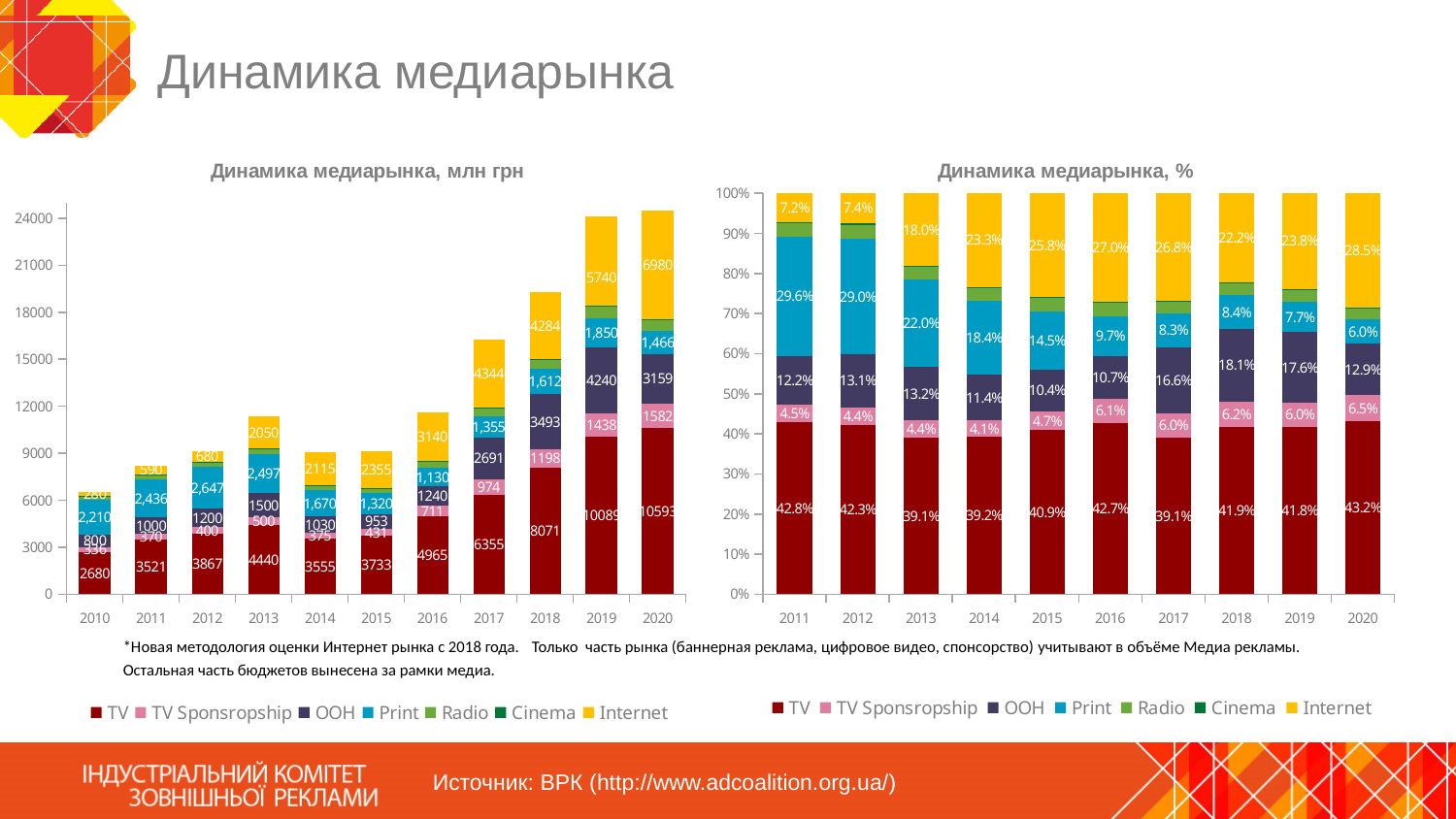
How many years are shown on the x axis of the chart 'Динамика медиарынка, %'? 10 In the chart 'Динамика медиарынка, %', what is the Print share in 2011? 29.6% In the chart 'Динамика медиарынка, млн грн', what is the value for TV in 2020? 10593 In the chart 'Динамика медиарынка, млн грн', what is the difference between the TV values for 2020 and 2019? 504 How many series does the legend of the chart 'Динамика медиарынка, млн грн' list? 7 In the chart 'Динамика медиарынка, млн грн', what is the value for Internet in 2019? 5740 What kind of chart is 'Динамика медиарынка, млн грн'? stacked bar chart In the chart 'Динамика медиарынка, %', what is the Internet share in 2020? 28.5% In the chart 'Динамика медиарынка, млн грн', which year has the lowest TV value? 2010 In the chart 'Динамика медиарынка, %', which year has the larger TV share, 2013 or 2020? 2020 In the chart 'Динамика медиарынка, %', does the Print share rise or fall from 2011 to 2020? fall In the chart 'Динамика медиарынка, млн грн', which year has the highest TV value? 2020